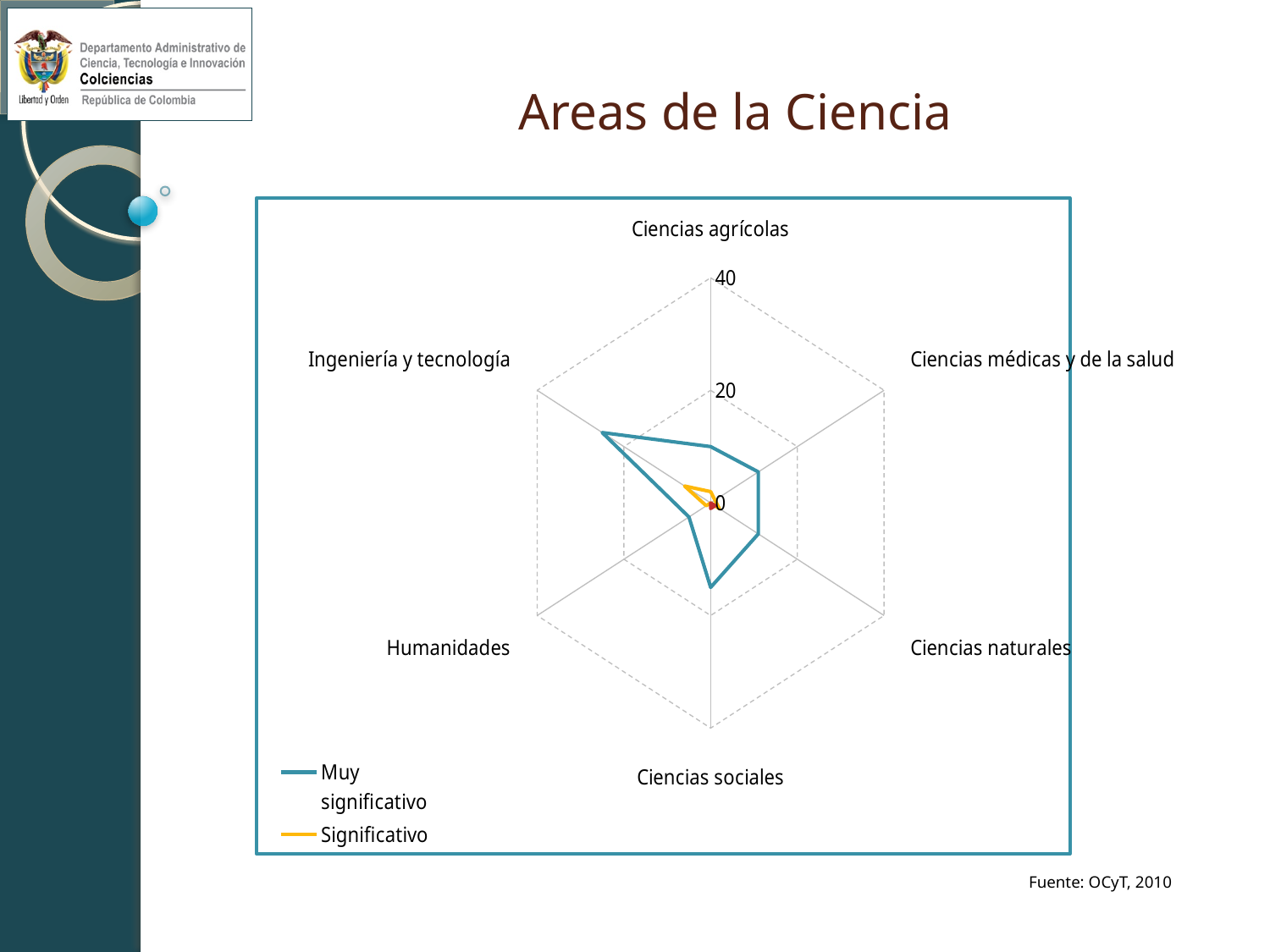
Which category has the lowest value for the 'Muy significativo' series? Humanidades Is the 'Muy significativo' value for Ciencias agrícolas greater or less than 20? less Which category has the highest value for the 'Muy significativo' series? Ingeniería y tecnología What kind of chart is shown on the slide? Radar chart Is the 'Muy significativo' value for Ciencias sociales greater or less than 20? less For the 'Muy significativo' series, which is larger: Ingeniería y tecnología or Ciencias agrícolas? Ingeniería y tecnología For Ingeniería y tecnología, which series has the larger value: 'Muy significativo' or 'Significativo'? Muy significativo What is the title of the slide containing the chart? Areas de la Ciencia How many areas of science (categories) are plotted on the radar chart? 6 What is the highest value shown on the chart's axis scale? 40 Is the 'Muy significativo' value for Ingeniería y tecnología greater or less than 20? greater How many series does the legend of the chart list? 2